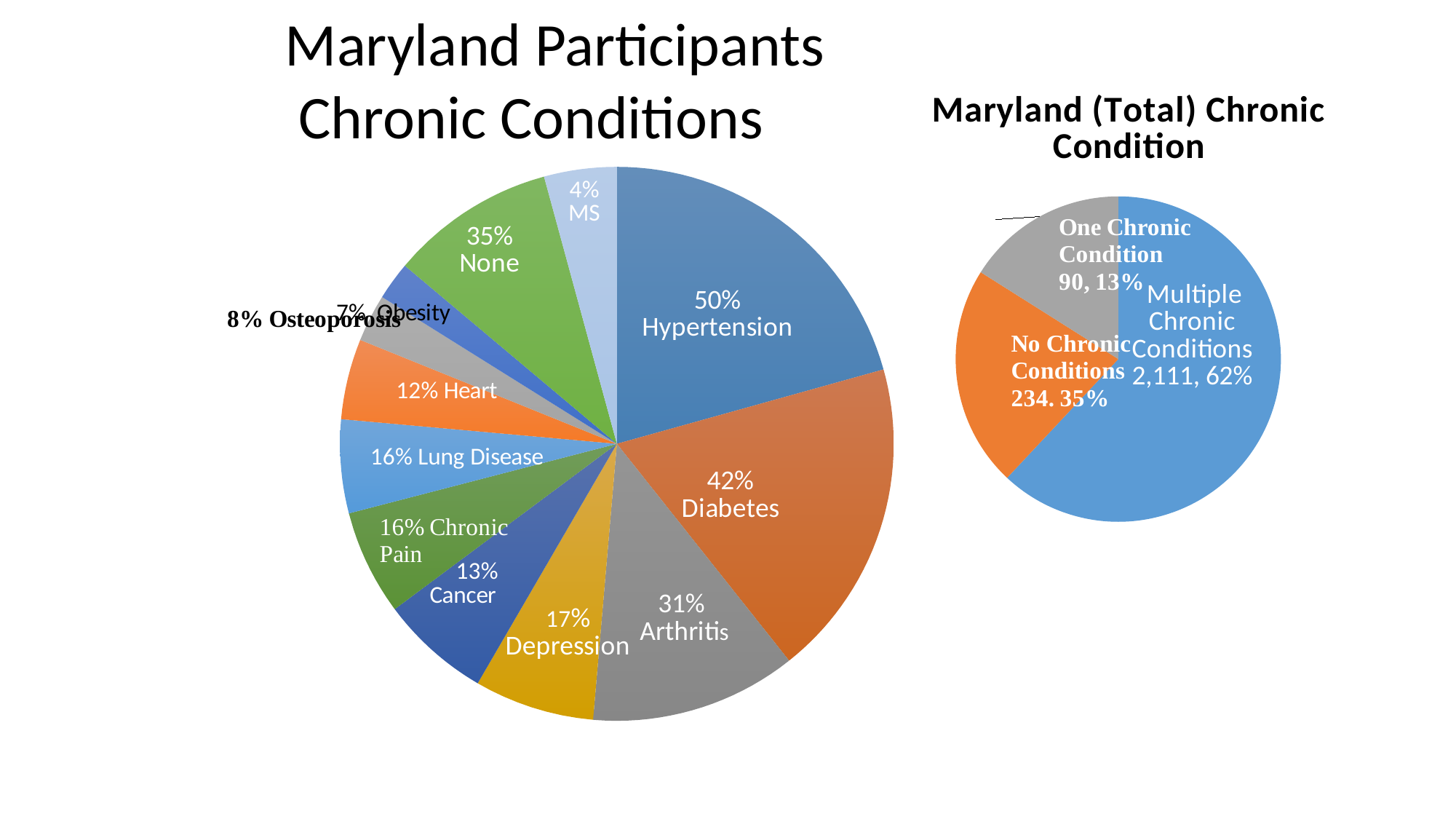
In the 'Maryland (Total) Chronic Condition' chart, what percentage is shown for One Chronic Condition? 13% In the 'Maryland Participants Chronic Conditions' chart, which is larger, Depression or Cancer? Depression In the 'Maryland Participants Chronic Conditions' chart, what is the difference in percentage points between Hypertension and Diabetes? 8 How many slices does the 'Maryland Participants Chronic Conditions' pie chart have? 12 In the 'Maryland Participants Chronic Conditions' chart, what percentage is shown for Diabetes? 42% In the 'Maryland Participants Chronic Conditions' chart, what percentage is shown for Hypertension? 50% In the 'Maryland Participants Chronic Conditions' chart, which slice is the largest? Hypertension What type of chart is the 'Maryland (Total) Chronic Condition' chart? Pie chart In the 'Maryland Participants Chronic Conditions' chart, what percentage is shown for Arthritis? 31% In the 'Maryland (Total) Chronic Condition' chart, what count and percentage are shown for Multiple Chronic Conditions? 2,111, 62% How many slices does the 'Maryland (Total) Chronic Condition' pie chart have? 3